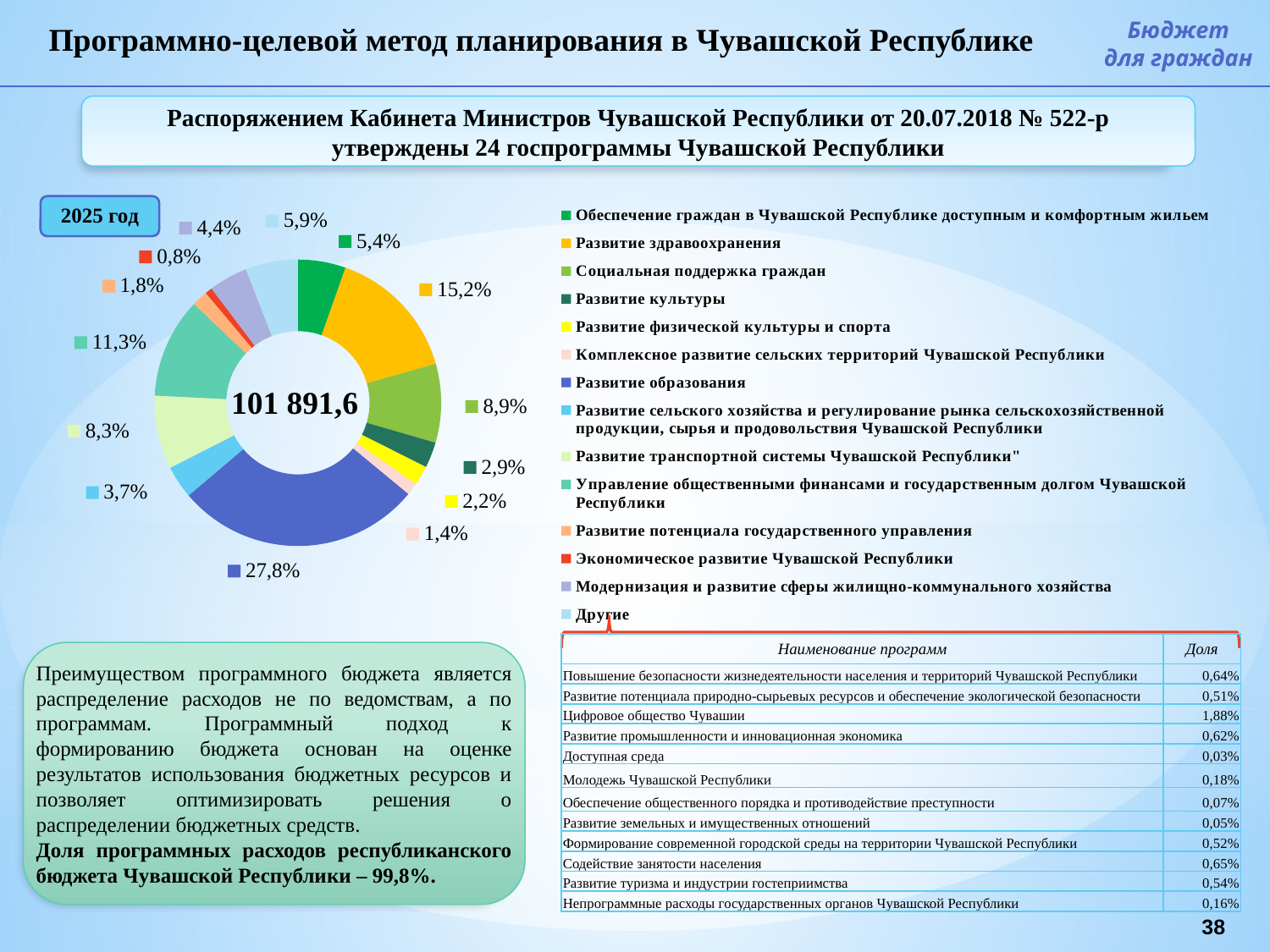
What year is indicated in the label next to the doughnut chart? 2025 год What is the difference between the shares for "Развитие здравоохранения" (15,2%) and "Обеспечение граждан в Чувашской Республике доступным и комфортным жильем" (5,4%)? 9,8% Which category has the largest share in the doughnut chart? Развитие образования What kind of chart is shown on the slide? doughnut (pie) chart Which has the larger share: "Социальная поддержка граждан" or "Развитие транспортной системы Чувашской Республики"? Социальная поддержка граждан What share does the chart show for "Другие"? 5,9% How many categories does the legend of the doughnut chart list? 14 What share does the chart show for "Управление общественными финансами и государственным долгом Чувашской Республики"? 11,3% What value is printed in the centre of the doughnut chart? 101 891,6 Which category has the smallest share in the doughnut chart? Экономическое развитие Чувашской Республики What share does the chart show for "Развитие здравоохранения"? 15,2% What share does the chart show for "Развитие образования"? 27,8%